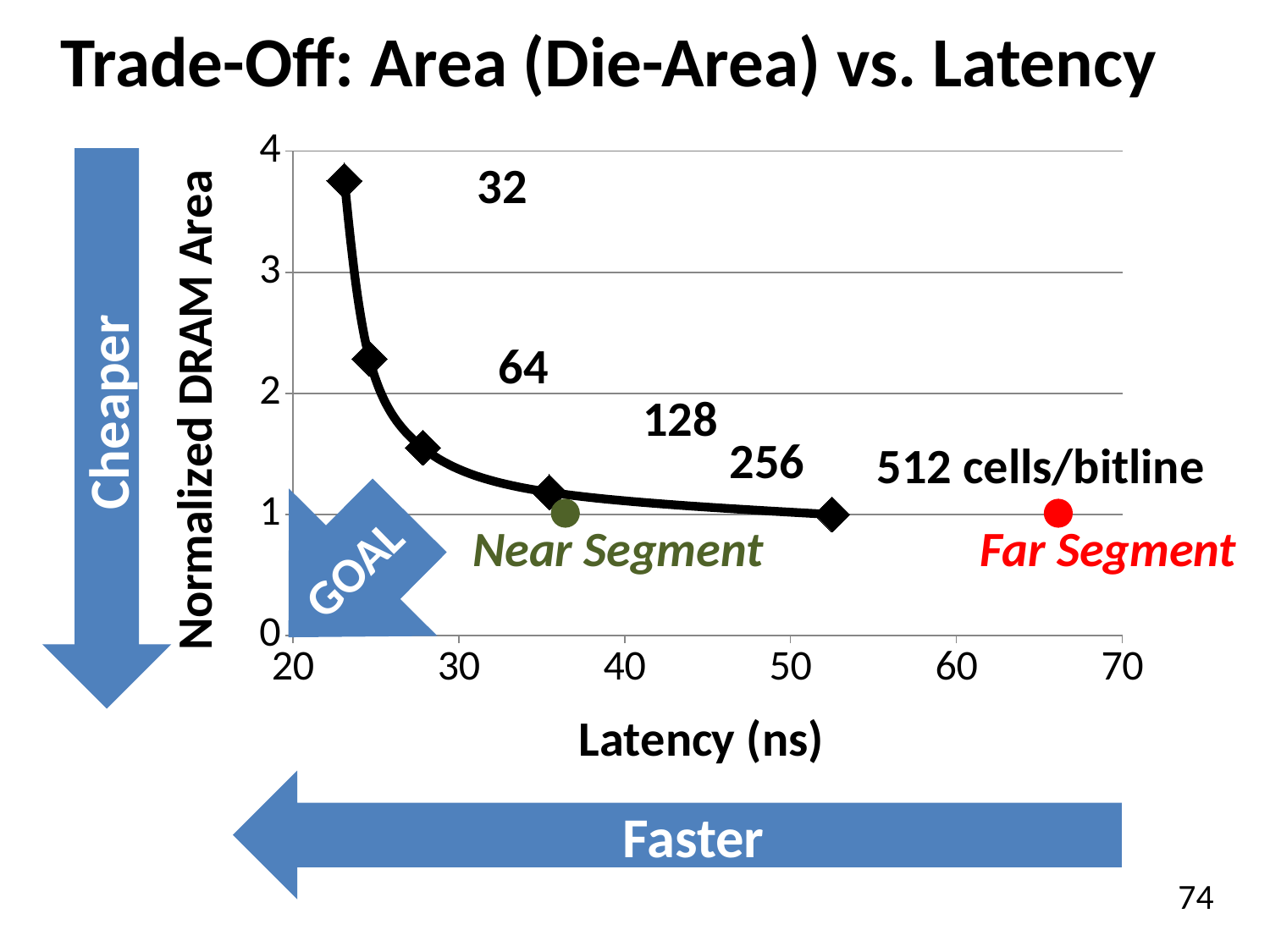
Which cells/bitline configuration has the highest normalized DRAM area? 32 Is the latency of the Near Segment point greater or less than 40 ns? less What is the title of the chart on the slide? Trade-Off: Area (Die-Area) vs. Latency Is the normalized DRAM area for 32 cells/bitline greater or less than 3? greater Which cells/bitline configuration has the lowest normalized DRAM area? 512 cells/bitline As latency increases along the x axis, does the normalized DRAM area rise or fall? fall How many black diamond data points are plotted on the curve? 5 Is the normalized DRAM area for 64 cells/bitline greater or less than 2? greater What is the label of the x axis? Latency (ns) Which has a larger normalized DRAM area, 64 cells/bitline or 256 cells/bitline? 64 cells/bitline